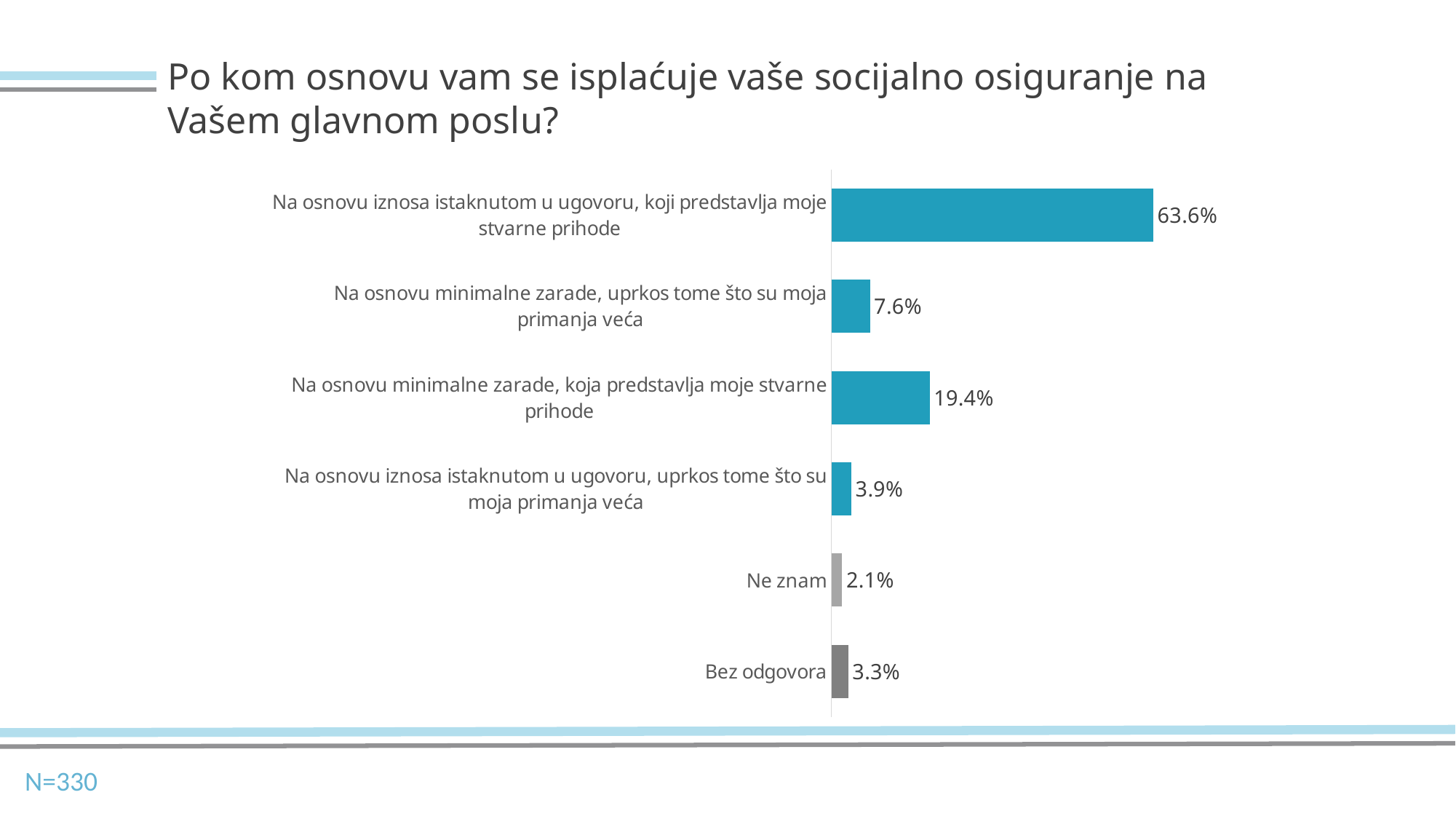
What is the difference between the values for "Na osnovu minimalne zarade, koja predstavlja moje stvarne prihode" and "Na osnovu minimalne zarade, uprkos tome što su moja primanja veća"? 11.8% What is the value for "Bez odgovora"? 3.3% Which category has the highest value? Na osnovu iznosa istaknutom u ugovoru, koji predstavlja moje stvarne prihode Which is larger: the value for "Bez odgovora" or the value for "Na osnovu iznosa istaknutom u ugovoru, uprkos tome što su moja primanja veća"? Na osnovu iznosa istaknutom u ugovoru, uprkos tome što su moja primanja veća What kind of chart is shown on the slide? Bar chart What is the value for "Na osnovu iznosa istaknutom u ugovoru, koji predstavlja moje stvarne prihode"? 63.6% What is the value for "Na osnovu minimalne zarade, koja predstavlja moje stvarne prihode"? 19.4% What sample size (N) is stated on the slide? N=330 How many categories are shown in the chart? 6 What is the value for "Ne znam"? 2.1% What is the value for "Na osnovu minimalne zarade, uprkos tome što su moja primanja veća"? 7.6% Which category has the lowest value? Ne znam